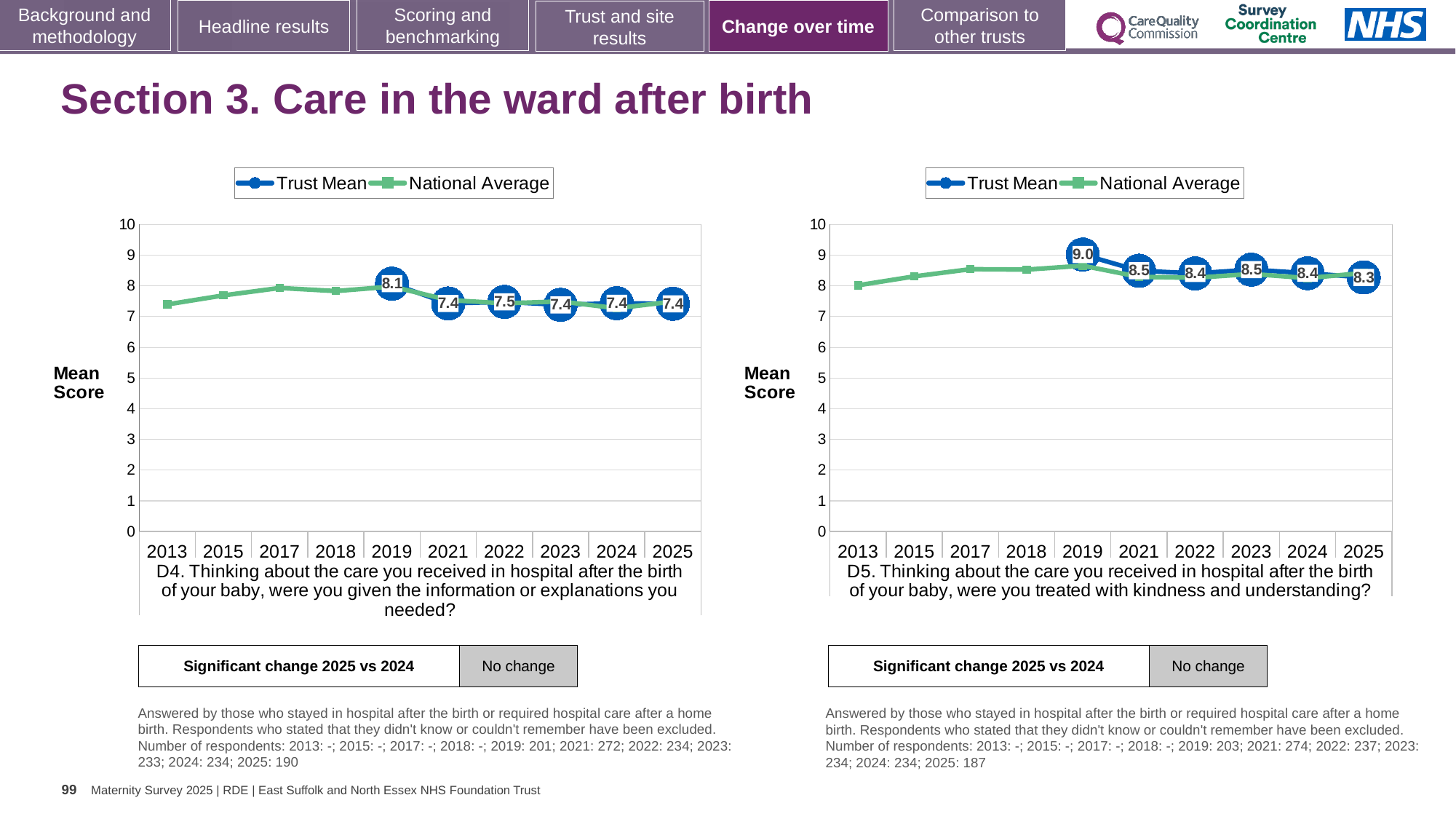
In the D4 chart on the left, what is the difference between the Trust Mean scores for 2019 and 2021? 0.7 In the D5 chart on the right, what is the Trust Mean score for 2025? 8.3 How many years are shown on the x axis of the D5 chart on the right? 10 What kind of chart is the D5 chart on the right? Line chart How many series does the legend of the D4 chart on the left list? 2 In the D4 chart on the left, is the National Average value for 2013 greater or less than 8? less In the D5 chart on the right, is the Trust Mean score for 2021 larger or smaller than the Trust Mean score for 2025? larger In the D4 chart on the left, which year has the highest Trust Mean score? 2019 In the D5 chart on the right, which year has the highest Trust Mean score? 2019 In the D5 chart on the right, what is the difference between the Trust Mean scores for 2019 and 2025? 0.7 In the D4 chart on the left, what is the Trust Mean score for 2019? 8.1 In the D4 chart on the left, what is the Trust Mean score for 2022? 7.5